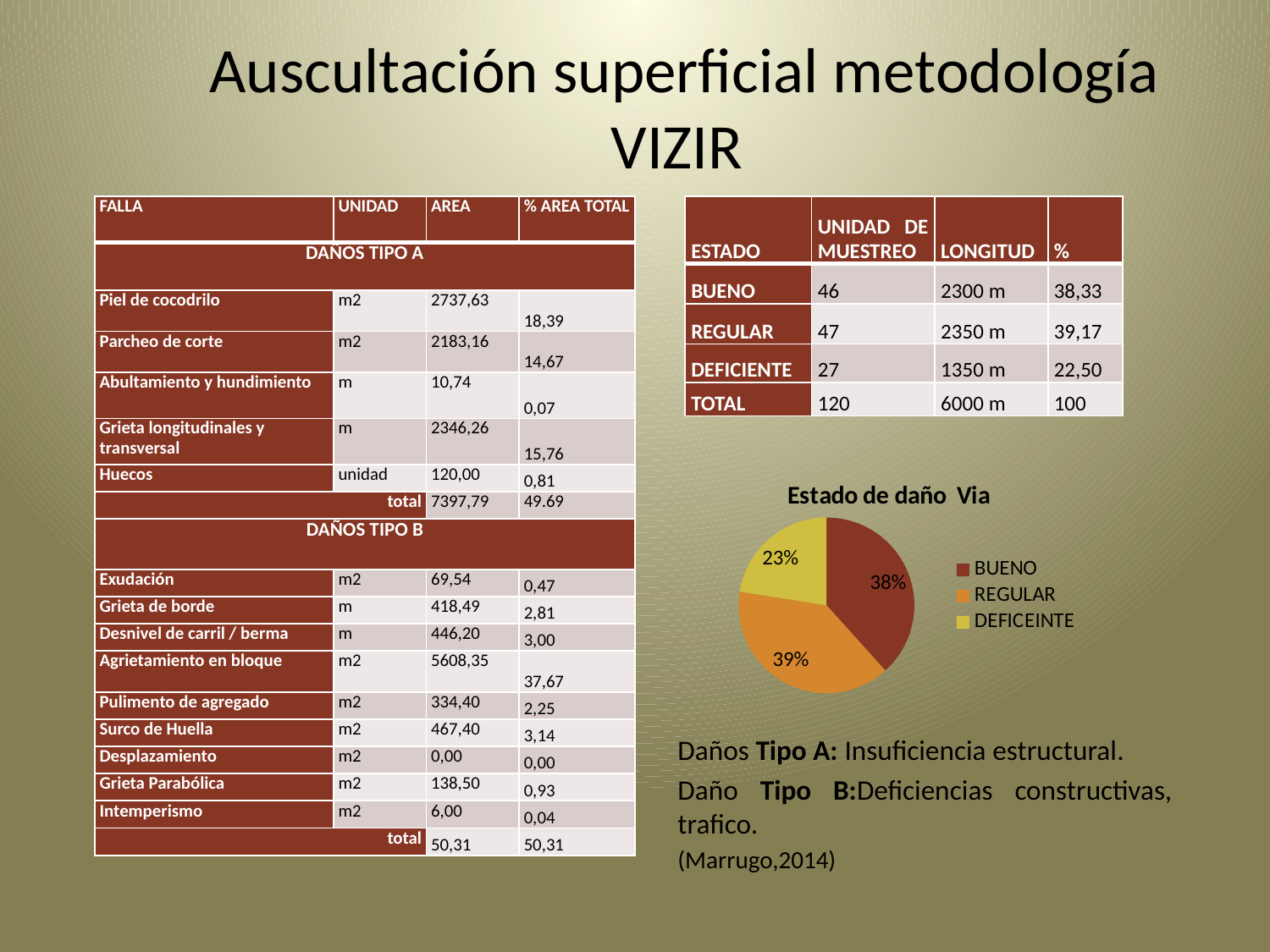
What percentage does the DEFICEINTE slice show in the pie chart? 23% What is the difference in percentage points between the REGULAR slice and the DEFICEINTE slice in the pie chart? 16 What kind of chart is shown on the slide? pie chart Which slice of the pie chart is the largest? REGULAR What is the title of the chart on the slide? Estado de daño Via Which slice of the pie chart is the smallest? DEFICEINTE In the pie chart, which is larger, the BUENO slice or the DEFICEINTE slice? BUENO What percentage does the REGULAR slice show in the pie chart? 39% Which legend entry in the pie chart is shown in yellow? DEFICEINTE How many slices does the pie chart have? 3 How many entries does the legend of the pie chart list? 3 What percentage does the BUENO slice show in the pie chart? 38%